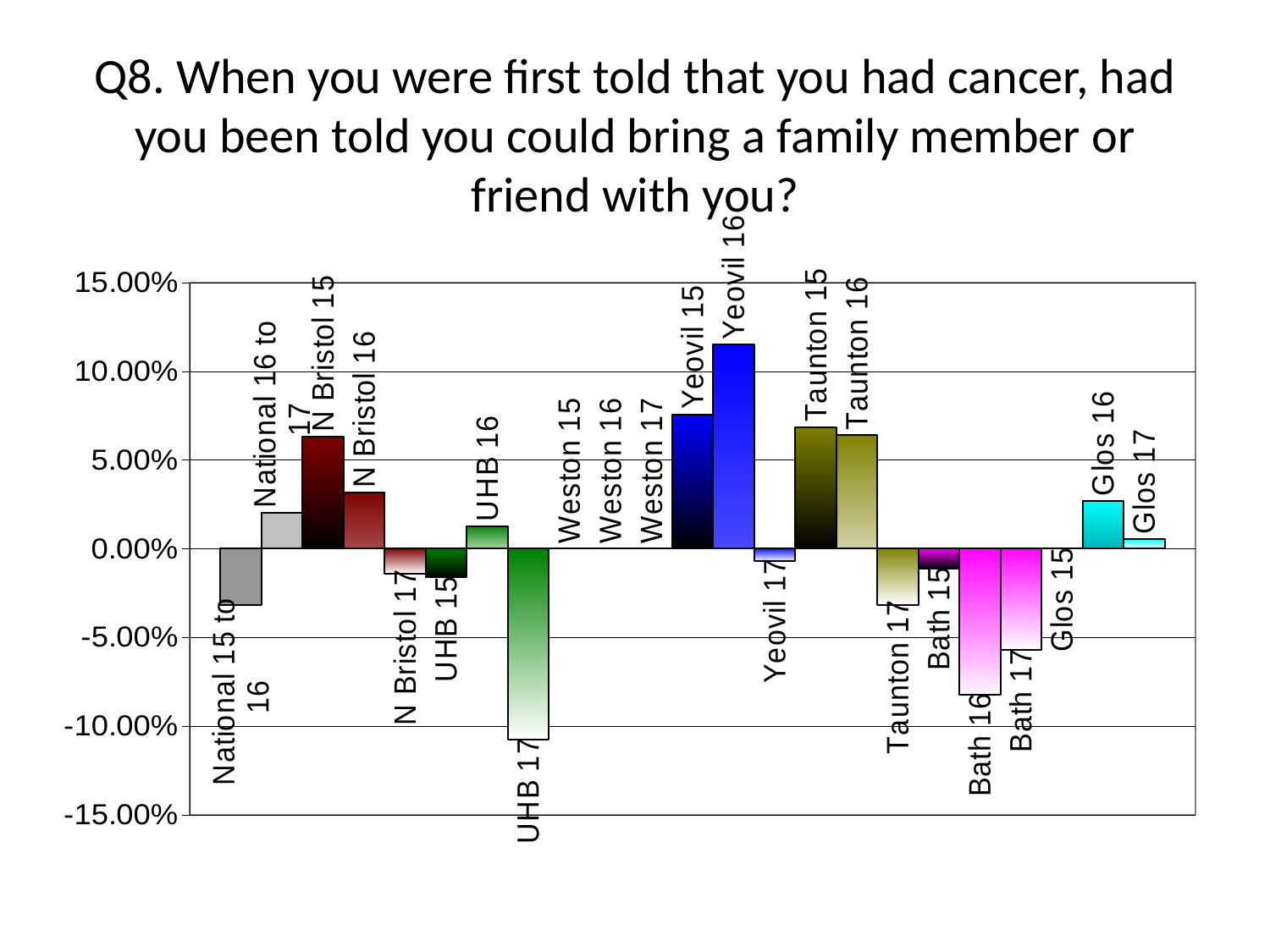
Which is larger, the value for Yeovil 15 or the value for N Bristol 15? Yeovil 15 Is the value for Bath 16 greater or less than -5.00%? less What kind of chart is shown on the slide? bar chart Is the value for Yeovil 16 greater or less than 10.00%? greater Is the value for N Bristol 15 greater or less than 5.00%? greater How many categories are plotted on the chart? 23 What is the title of the chart? Q8. When you were first told that you had cancer, had you been told you could bring a family member or friend with you? Which category has the lowest value? UHB 17 Which category has the highest value? Yeovil 16 Which is larger, the value for Bath 16 or the value for Bath 17? Bath 17